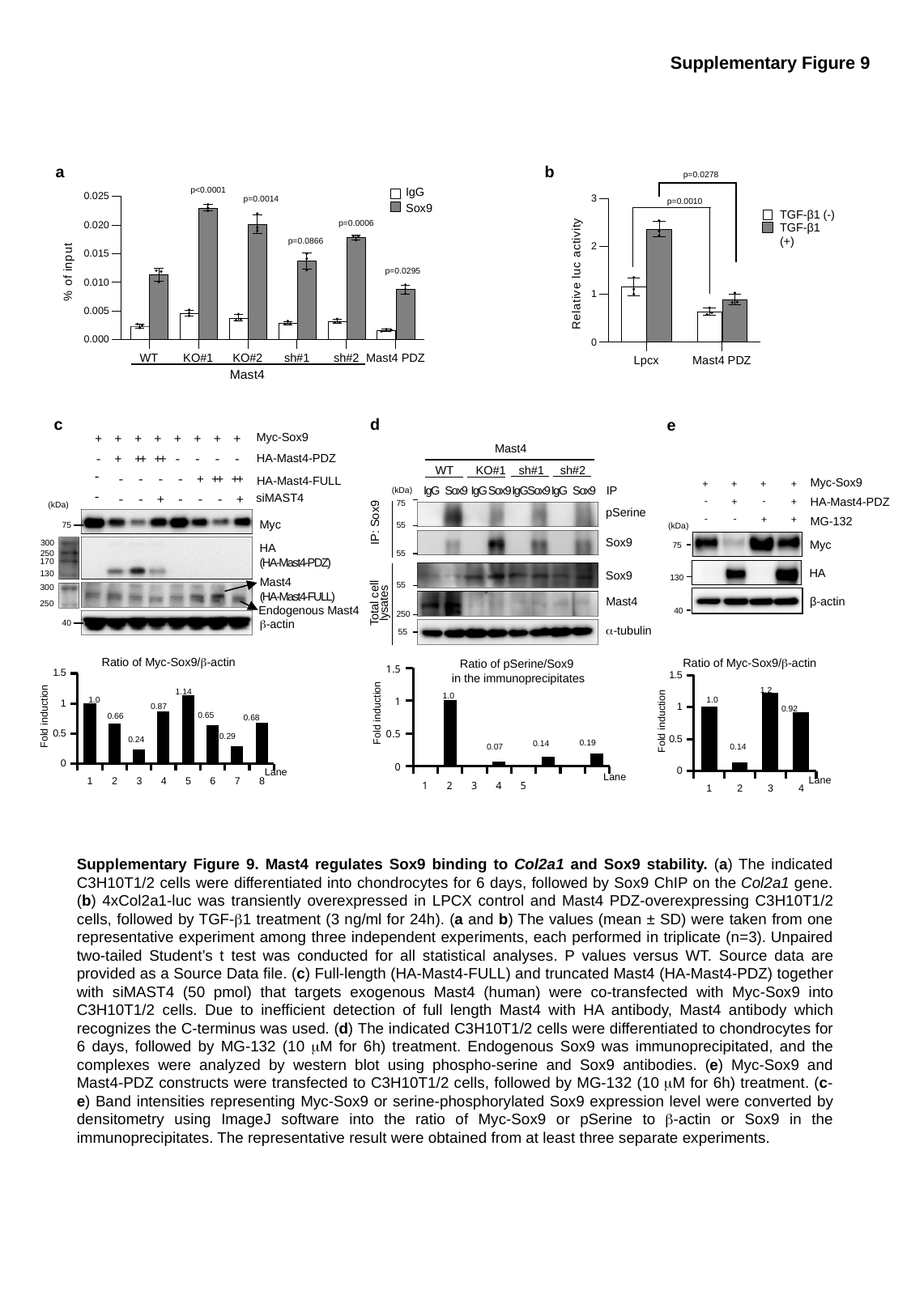
In the chart in panel a (% of input), is the Sox9 value for KO#1 greater or less than 0.020? greater In the bar chart in panel c (Ratio of Myc-Sox9/β-actin), what is the difference in fold induction between lane 1 and lane 3? 0.76 In the chart in panel b (Relative luc activity), is the TGF-β1 (+) value for Lpcx greater or less than 2? greater In the bar chart in panel e (Ratio of Myc-Sox9/β-actin), what is the fold induction for lane 2? 0.14 In the bar chart in panel c (Ratio of Myc-Sox9/β-actin), which lane has the lowest fold induction? Lane 3 In the bar chart in panel c (Ratio of Myc-Sox9/β-actin), what is the fold induction for lane 5? 1.14 In the chart in panel a (% of input), how many series does the legend list? 2 In the bar chart in panel d (Ratio of pSerine/Sox9 in the immunoprecipitates), what is the highest fold induction value shown? 1.0 In the bar chart in panel c (Ratio of Myc-Sox9/β-actin), how many lanes are plotted on the x axis? 8 What kind of chart is shown in panel b (Relative luc activity)? Bar chart In the bar chart in panel e (Ratio of Myc-Sox9/β-actin), which lane has the highest fold induction? Lane 3 In the bar chart in panel e (Ratio of Myc-Sox9/β-actin), is the fold induction for lane 1 or lane 4 larger? Lane 1